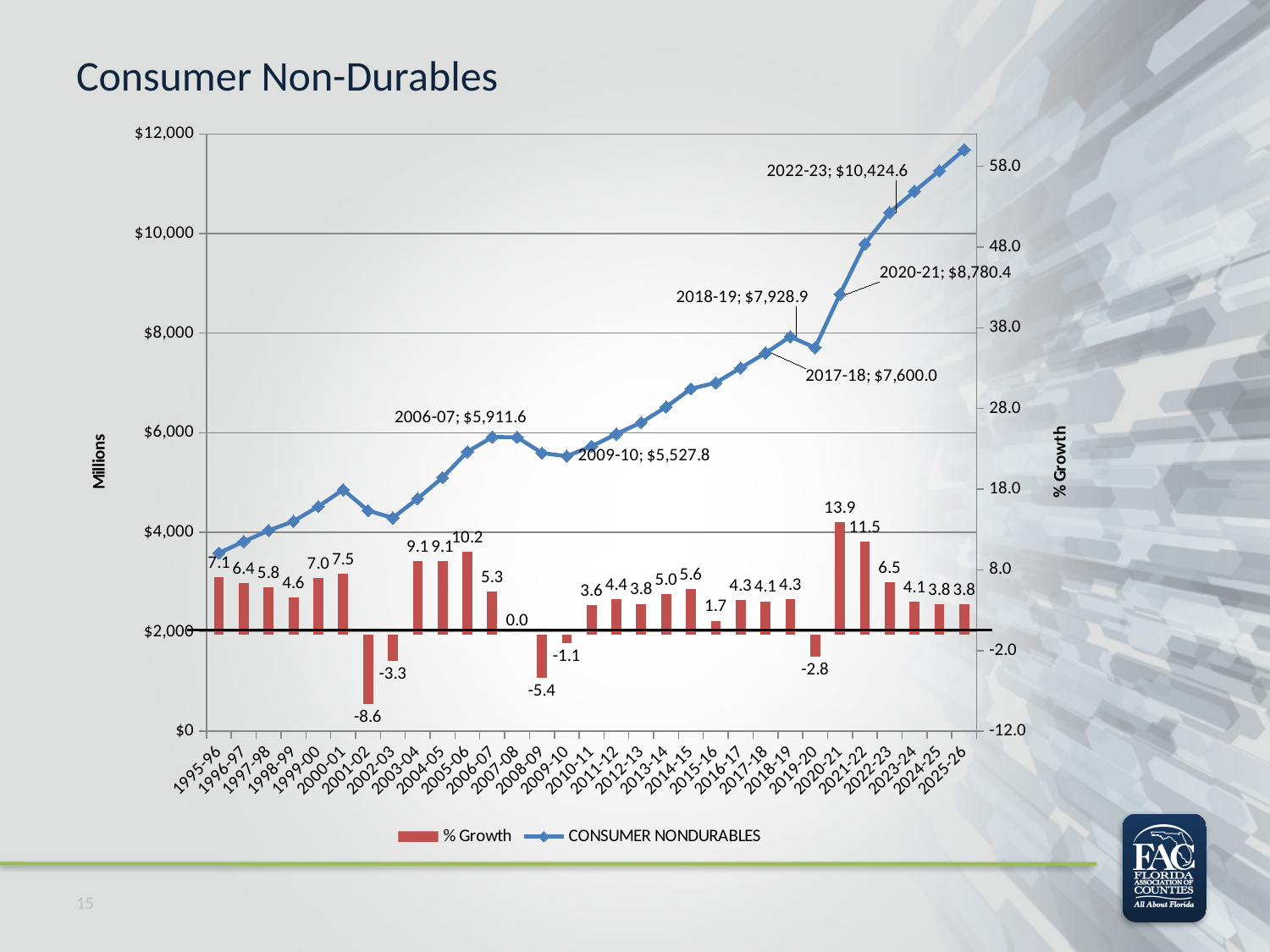
What kind of chart is shown on the slide? Combination bar and line chart Which year has the lowest % Growth? 2001-02 By how much does the % Growth for 2020-21 exceed that for 2021-22? 2.4 What is the % Growth value for 2007-08? 0.0 How many fiscal years are shown on the x axis? 31 What is the % Growth value for 2020-21? 13.9 What is the difference between the CONSUMER NONDURABLES values labelled for 2022-23 and 2020-21? $1,644.2 Is the CONSUMER NONDURABLES value for 2025-26 greater or less than $10,000? greater How many series does the legend list? 2 Which year has the highest % Growth? 2020-21 What is the CONSUMER NONDURABLES value labelled for 2022-23? $10,424.6 Which year has the larger % Growth, 2005-06 or 2006-07? 2005-06